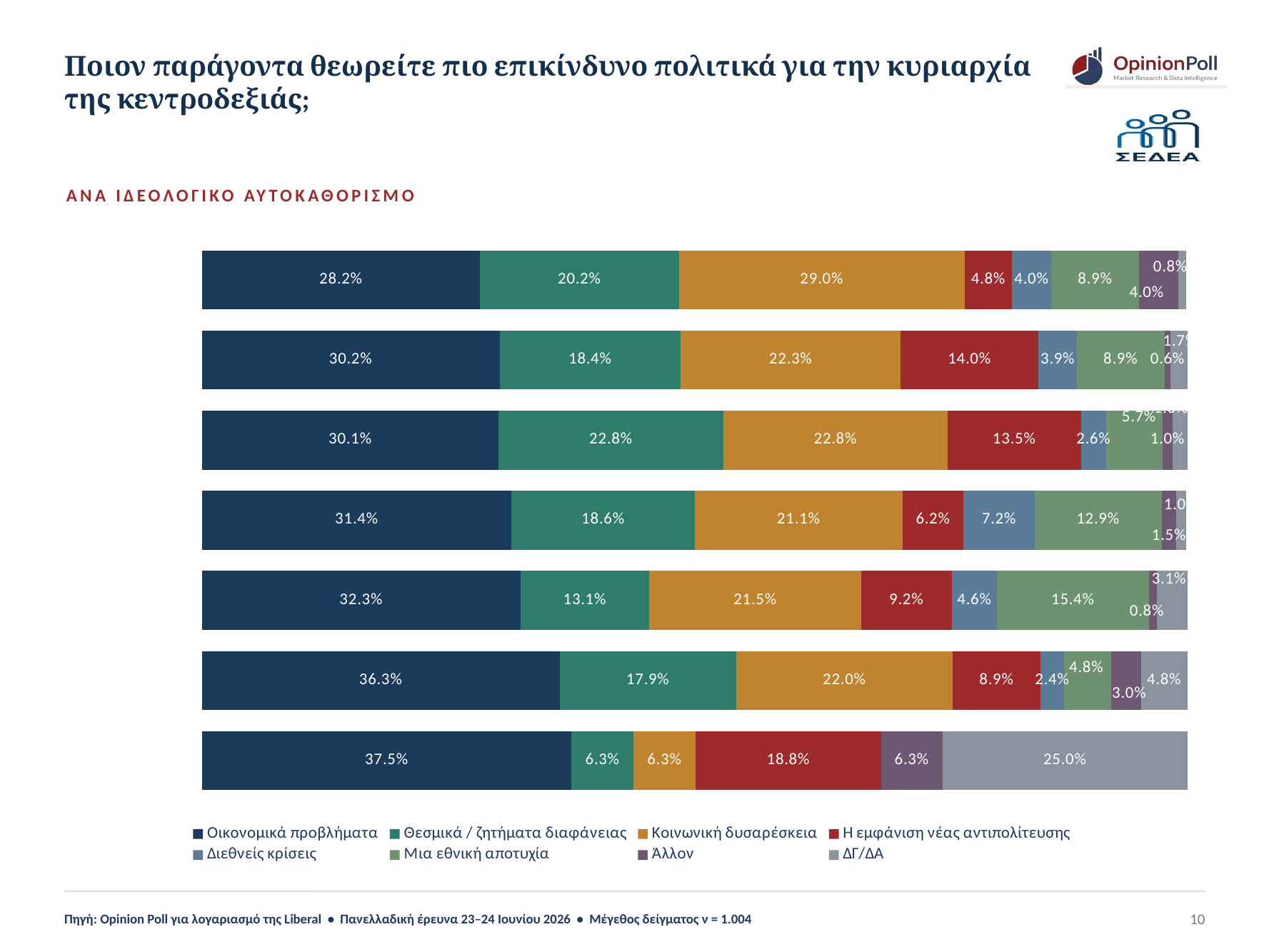
In the top bar, which is larger: Οικονομικά προβλήματα or Κοινωνική δυσαρέσκεια? Κοινωνική δυσαρέσκεια Which bar has the highest value for Η εμφάνιση νέας αντιπολίτευσης? The bottom bar (18.8%) Which bar has the highest value for Οικονομικά προβλήματα? The bottom bar (37.5%) In the bottom bar, what is the value for ΔΓ/ΔΑ? 25.0% What kind of chart is shown on the slide? Stacked bar chart How many series does the legend list? 8 How many stacked bars are plotted in the chart? 7 In the sixth bar from the top, what is the value for Θεσμικά / ζητήματα διαφάνειας? 17.9% In the top bar, what is the value for Κοινωνική δυσαρέσκεια? 29.0% In the bottom bar, what is the value for Οικονομικά προβλήματα? 37.5% In the fifth bar from the top, what is the value for Μια εθνική αποτυχία? 15.4% In the second bar from the top, what is the difference between Οικονομικά προβλήματα and Θεσμικά / ζητήματα διαφάνειας? 11.8 percentage points